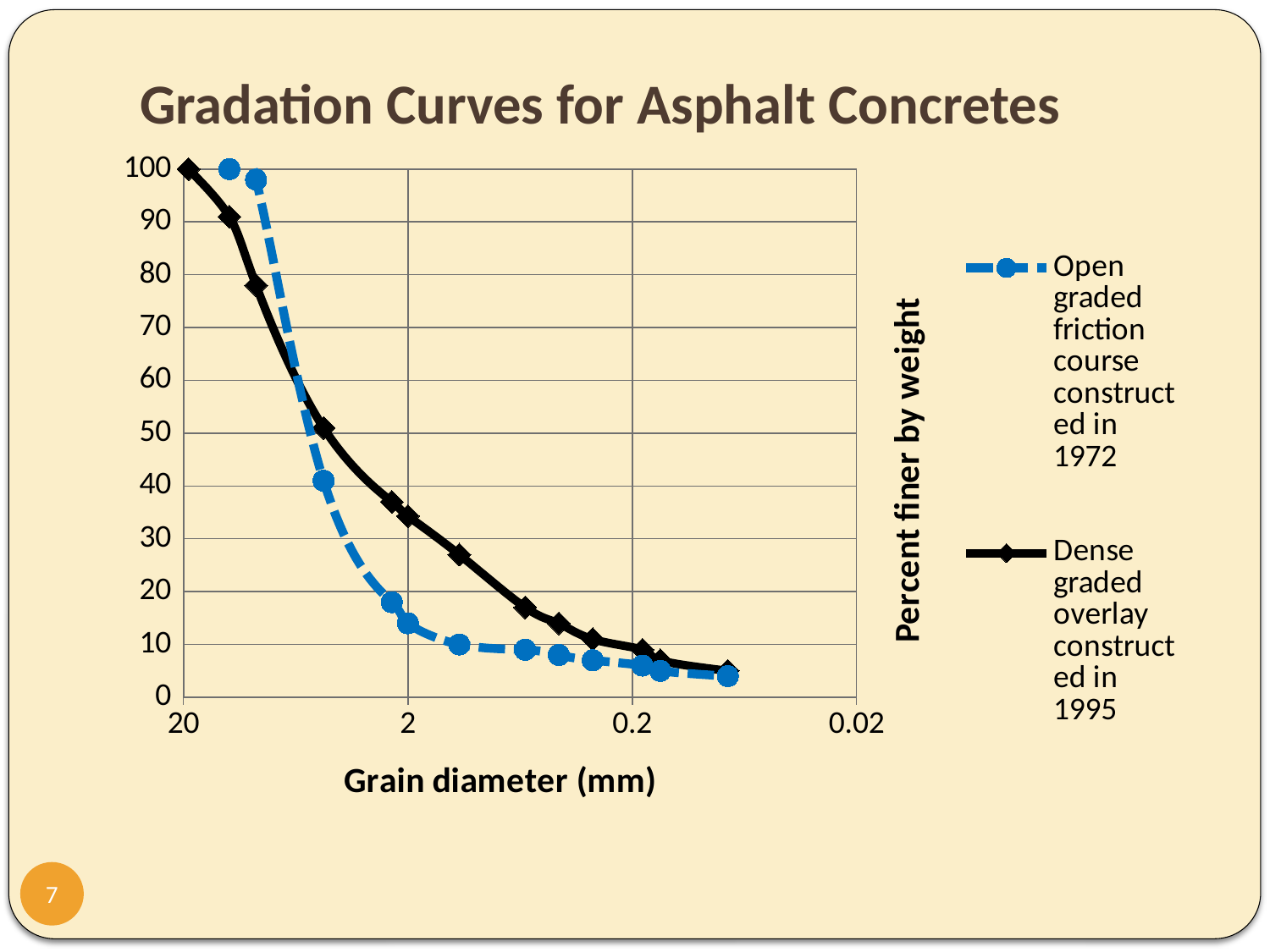
Is the percent finer by weight for the open graded friction course constructed in 1972 at a grain diameter of 2 mm greater or less than 20? less Is the percent finer by weight for the dense graded overlay constructed in 1995 at a grain diameter of 2 mm greater or less than 30? greater Is the percent finer by weight for the open graded friction course constructed in 1972 at a grain diameter of 0.2 mm greater or less than 10? less What is the percent finer by weight for the dense graded overlay constructed in 1995 at a grain diameter of 20 mm? 100 What is the title of the chart? Gradation Curves for Asphalt Concretes At a grain diameter of 2 mm, which series has the higher percent finer by weight: the open graded friction course constructed in 1972 or the dense graded overlay constructed in 1995? Dense graded overlay constructed in 1995 What is the label of the horizontal axis? Grain diameter (mm) How many series does the legend list? 2 What kind of chart is shown on the slide? line chart Do the percent finer values rise or fall as you move from left to right along the grain diameter axis? fall